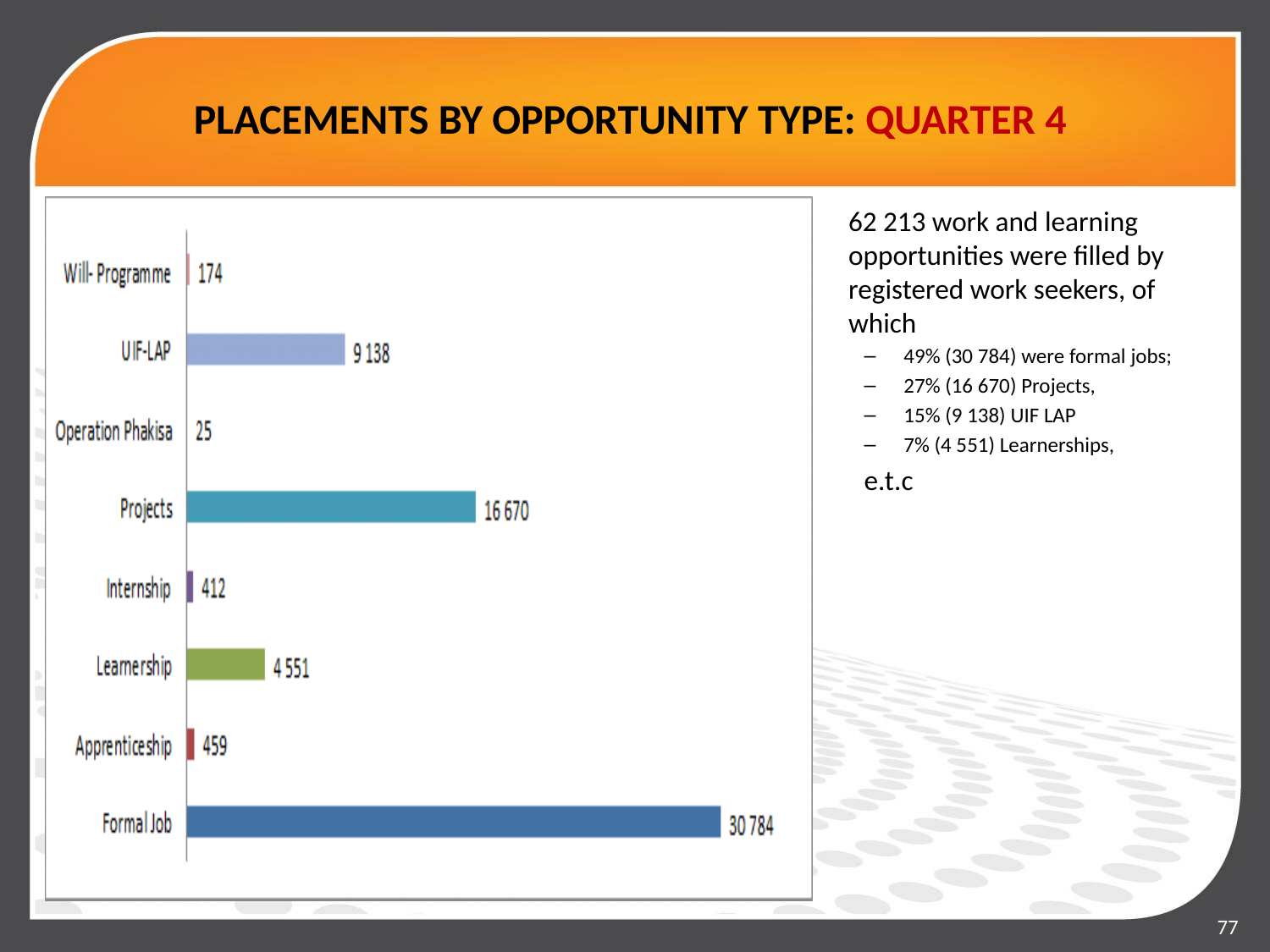
What kind of chart is shown on the slide? Bar chart Which opportunity type has the lowest number of placements? Operation Phakisa What is the value for Operation Phakisa? 25 What is the value for Projects? 16 670 What is the difference between the values for Formal Job and Projects? 14 114 What is the value for Will- Programme? 174 Which opportunity type has the highest number of placements? Formal Job What is the difference between the values for Apprenticeship and Internship? 47 What is the value for Formal Job? 30 784 How many opportunity types are shown in the chart? 8 What is the value for UIF-LAP? 9 138 Which is larger, the value for Learnership or the value for UIF-LAP? UIF-LAP